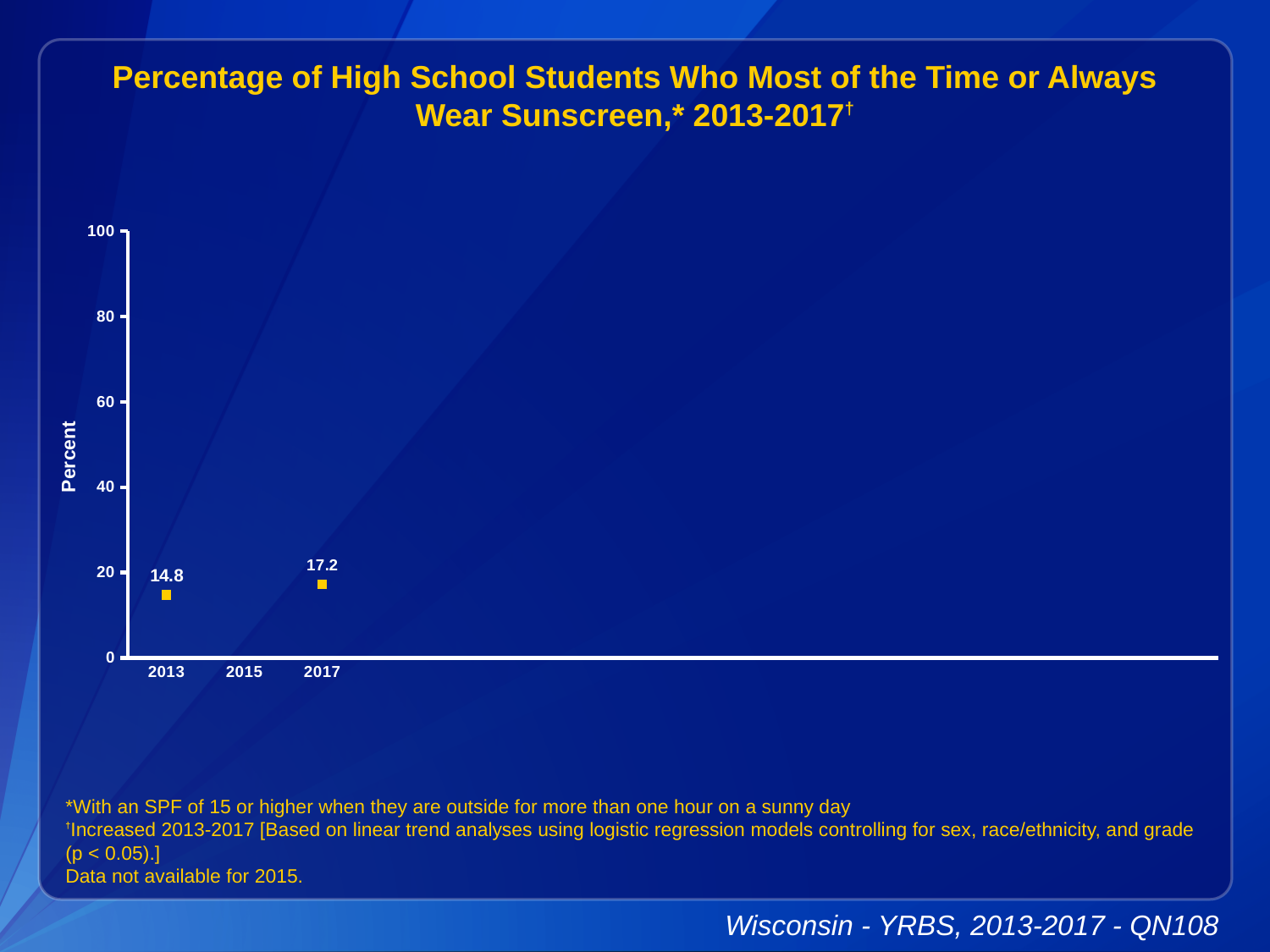
What is the percentage of high school students who most of the time or always wear sunscreen in 2017? 17.2 How many years are labeled on the x axis? 3 Which year has the lowest plotted percentage of students who wear sunscreen? 2013 Which year has the highest percentage of students who wear sunscreen? 2017 What is the label of the y axis? Percent What is the difference between the 2017 and 2013 values? 2.4 Is the value for 2017 larger or smaller than the value for 2013? larger What is the percentage of high school students who most of the time or always wear sunscreen in 2013? 14.8 Is the value for 2013 greater or less than 20? less How many years have data points plotted on the chart? 2 For which year is data not available? 2015 Does the percentage rise or fall from 2013 to 2017? rise